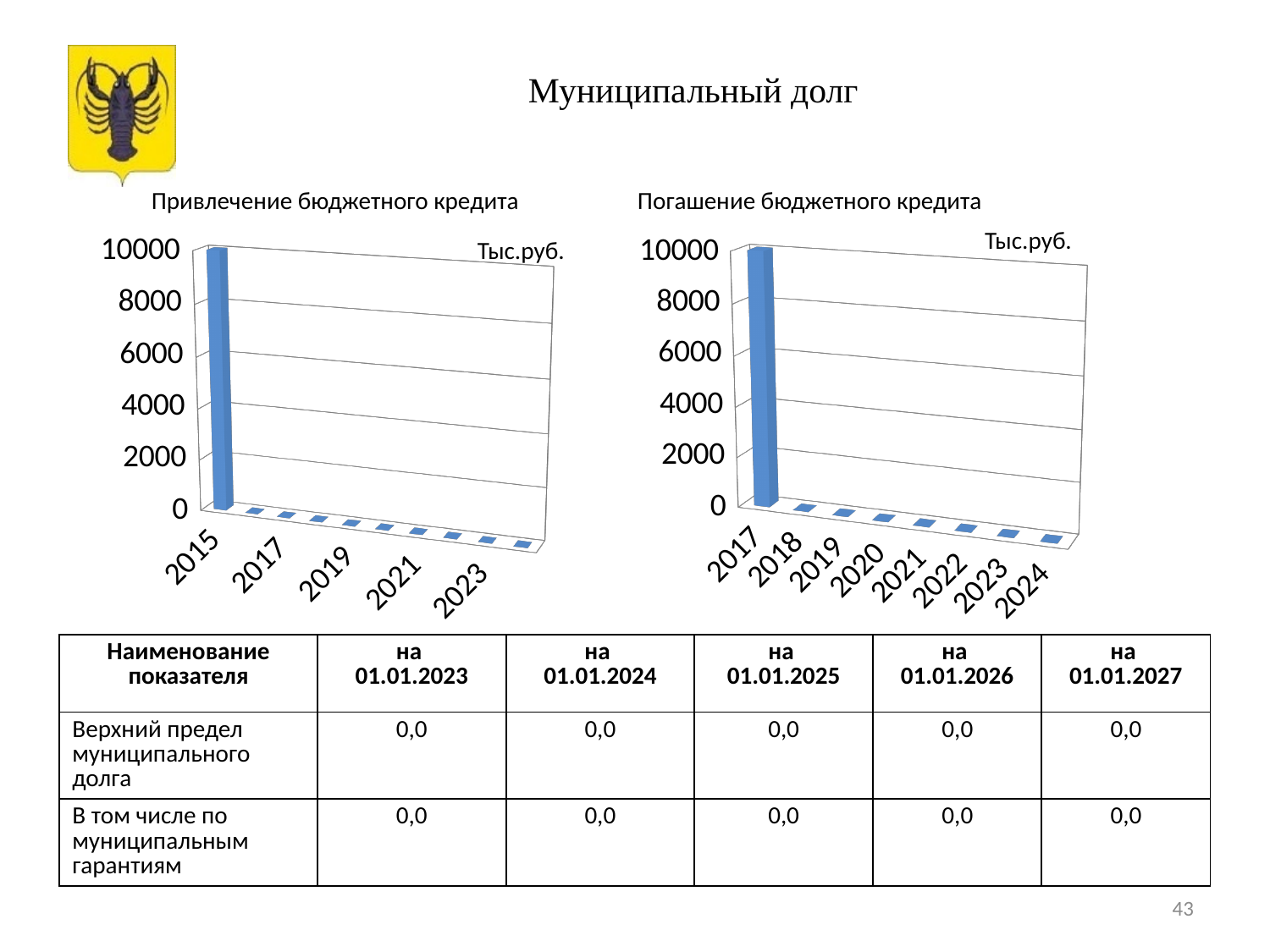
In the left chart 'Привлечение бюджетного кредита', is the value for 2015 greater or less than 8000? greater In the right chart 'Погашение бюджетного кредита', which is larger, the value for 2017 or the value for 2024? 2017 In the right chart 'Погашение бюджетного кредита', which year has the highest value? 2017 How many bars are plotted in the right chart 'Погашение бюджетного кредита'? 8 What kind of chart is the left chart, 'Привлечение бюджетного кредита'? bar chart In the left chart 'Привлечение бюджетного кредита', which is larger, the value for 2015 or the value for 2021? 2015 In the right chart 'Погашение бюджетного кредита', is the value for 2022 greater or less than 2000? less What unit is shown on the charts? Тыс.руб. In the left chart 'Привлечение бюджетного кредита', which year has the highest value? 2015 Do the values in the right chart 'Погашение бюджетного кредита' rise or fall from 2017 to 2018? fall In the right chart 'Погашение бюджетного кредита', is the value for 2017 greater or less than 8000? greater